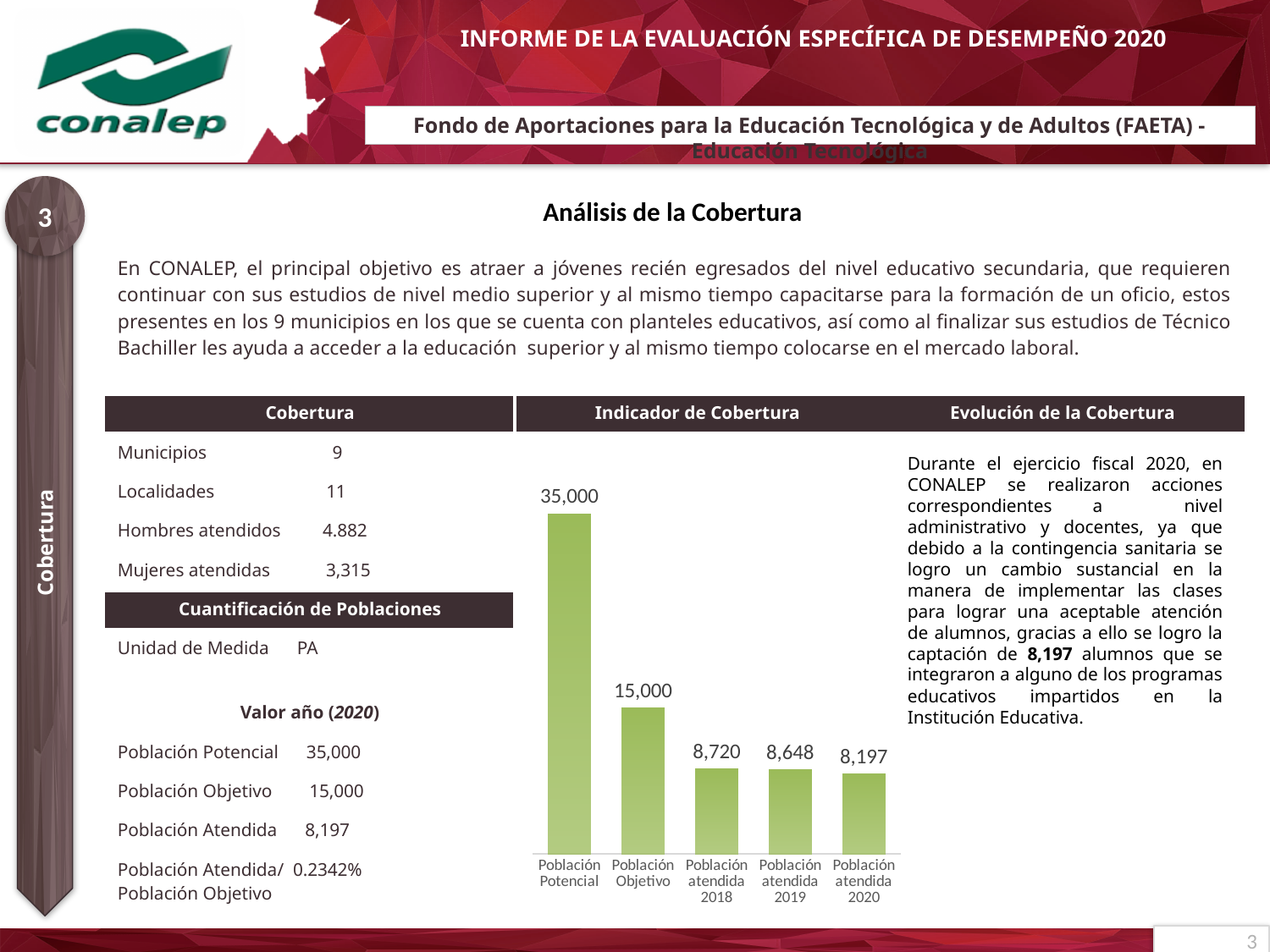
In the 'Indicador de Cobertura' chart, what is the value for Población Objetivo? 15,000 In the 'Indicador de Cobertura' chart, what is the value for Población atendida 2018? 8,720 In the 'Indicador de Cobertura' chart, what is the value for Población atendida 2020? 8,197 What type of chart is the 'Indicador de Cobertura' chart? Bar chart In the 'Indicador de Cobertura' chart, which category has the lowest value? Población atendida 2020 How many bars are shown in the 'Indicador de Cobertura' chart? 5 In the 'Indicador de Cobertura' chart, what is the value for Población atendida 2019? 8,648 In the 'Indicador de Cobertura' chart, what is the value for Población Potencial? 35,000 In the 'Indicador de Cobertura' chart, which category has the highest value? Población Potencial In the 'Indicador de Cobertura' chart, which is larger: Población Objetivo or Población atendida 2019? Población Objetivo In the 'Indicador de Cobertura' chart, what is the difference between Población atendida 2018 and Población atendida 2020? 523 In the 'Indicador de Cobertura' chart, what is the difference between Población Potencial and Población Objetivo? 20,000